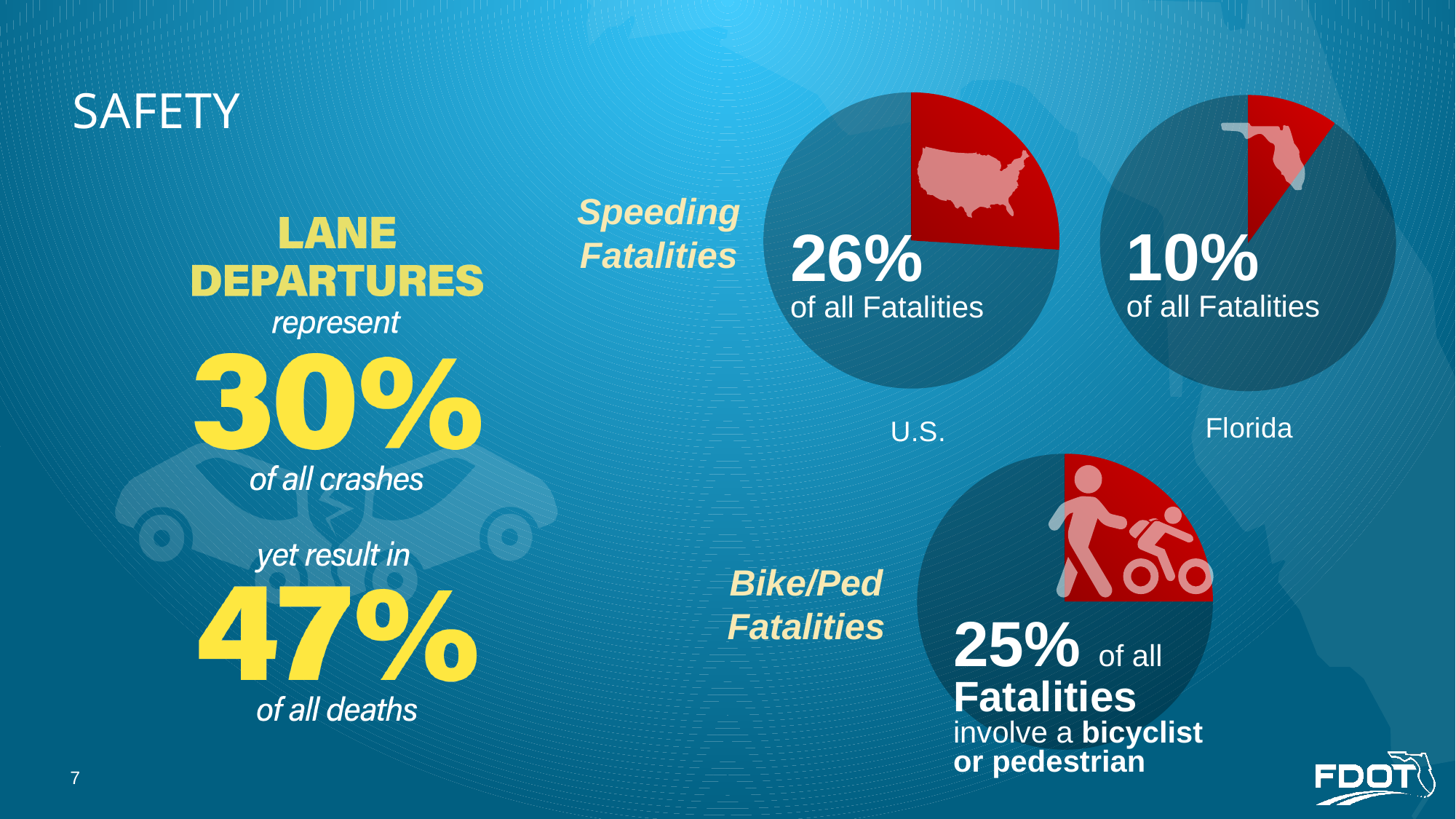
Which of the three pie charts shows the largest highlighted share? U.S. (Speeding Fatalities) In the Speeding Fatalities charts, how many regions are compared? 2 How many pie charts are shown on the slide? 3 In the Bike/Ped Fatalities chart, what share of all fatalities involve a bicyclist or pedestrian? 25% In the Speeding Fatalities charts, which region has the higher share of speeding fatalities, the U.S. or Florida? U.S. In the Speeding Fatalities charts, what share of all fatalities in Florida is attributed to speeding? 10% What colour is used for the highlighted slice in each pie chart? Red What is the label of the pie chart in the lower right of the slide? Bike/Ped Fatalities In the Speeding Fatalities charts, what is the difference between the U.S. and Florida speeding fatality shares? 16% In the Speeding Fatalities charts, what share of all fatalities in the U.S. is attributed to speeding? 26% Which of the three pie charts shows the smallest highlighted share? Florida (Speeding Fatalities) What kind of chart is used to show the Speeding Fatalities figures? Pie chart